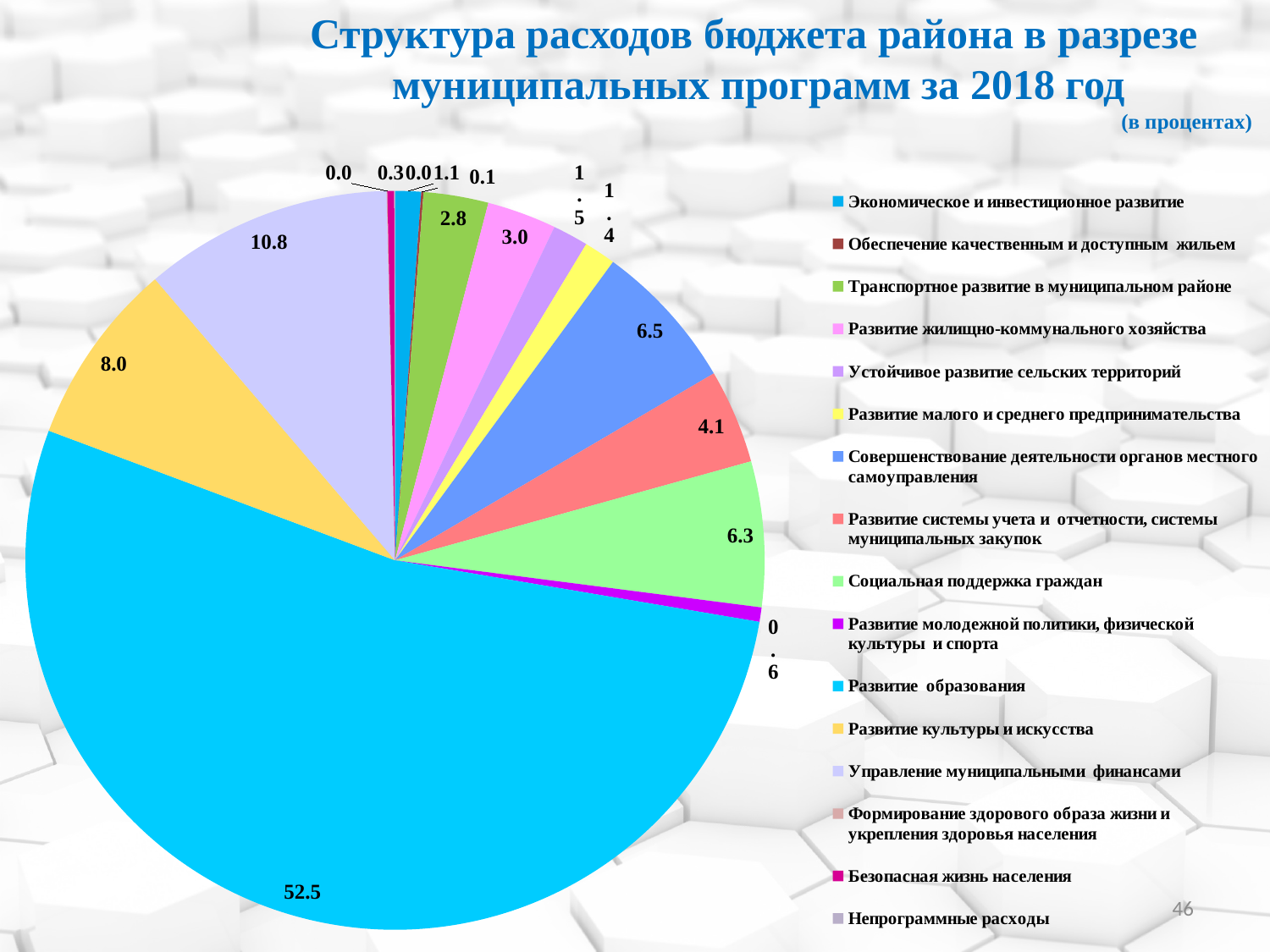
What is the value for Развитие культуры и искусства? 8.0 How many categories does the legend list? 16 What is the value for Развитие образования? 52.5 What is the value for Управление муниципальными финансами? 10.8 What type of chart is shown on the slide? Pie chart What share of the pie does Развитие образования take? 52.5 What is the value for Развитие жилищно-коммунального хозяйства? 3.0 What is the difference between the values for Управление муниципальными финансами and Развитие культуры и искусства? 2.8 What is the value for Социальная поддержка граждан? 6.3 Which is larger: Социальная поддержка граждан or Развитие системы учета и отчетности, системы муниципальных закупок? Социальная поддержка граждан What is the value for Совершенствование деятельности органов местного самоуправления? 6.5 Which category has the largest slice of the pie? Развитие образования